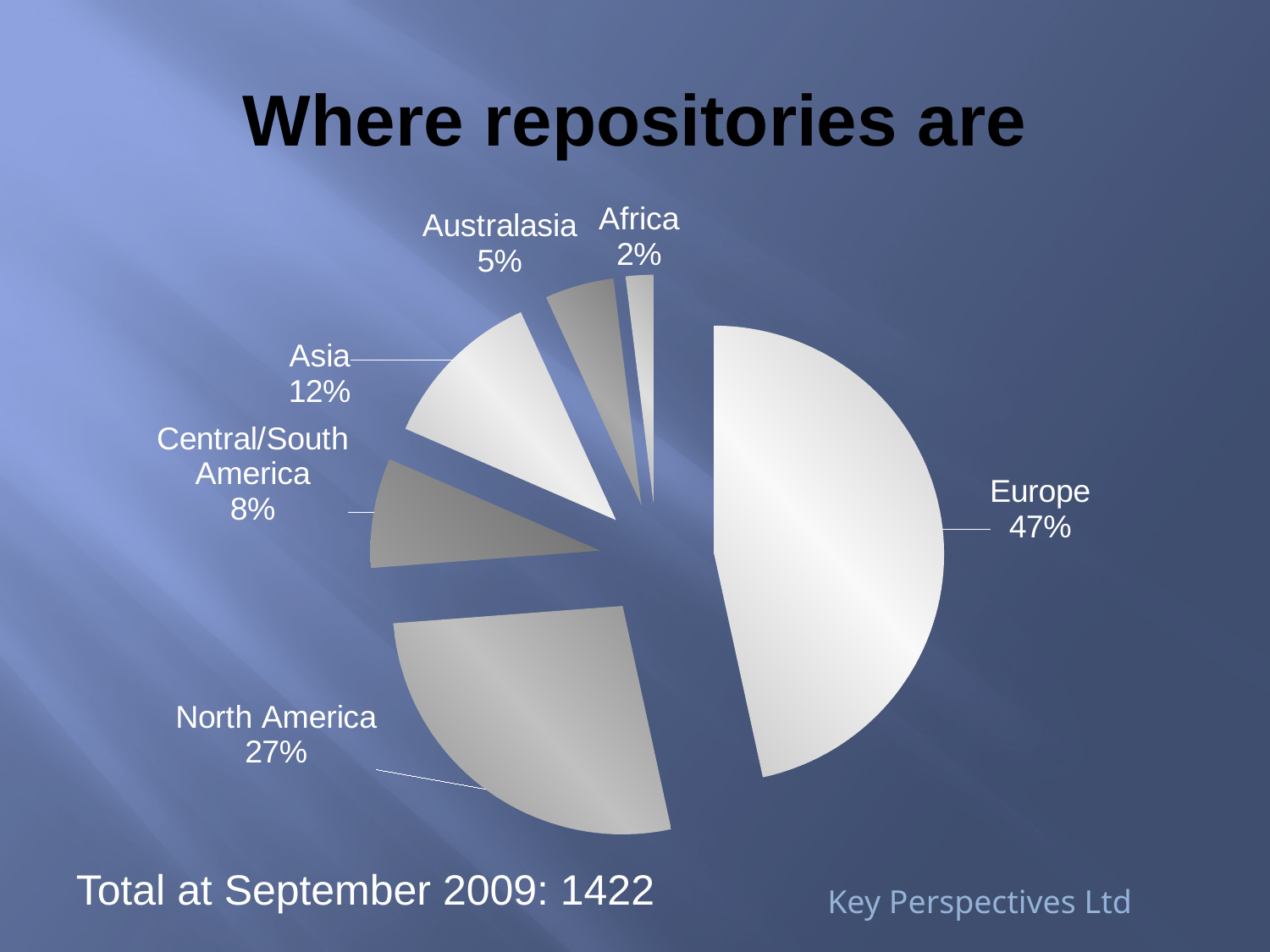
How many regions are shown in the pie chart? 6 Which region has the largest share of repositories? Europe Which region has the smallest share of repositories? Africa Which has a larger share, Asia or Central/South America? Asia What share of repositories is in Asia? 12% What is the difference in percentage points between Europe and North America? 20 What share of repositories is in North America? 27% What share of repositories is in Europe? 47% What share of repositories is in Africa? 2% What share of repositories is in Central/South America? 8% What kind of chart is shown on the slide? pie chart What share of repositories is in Australasia? 5%